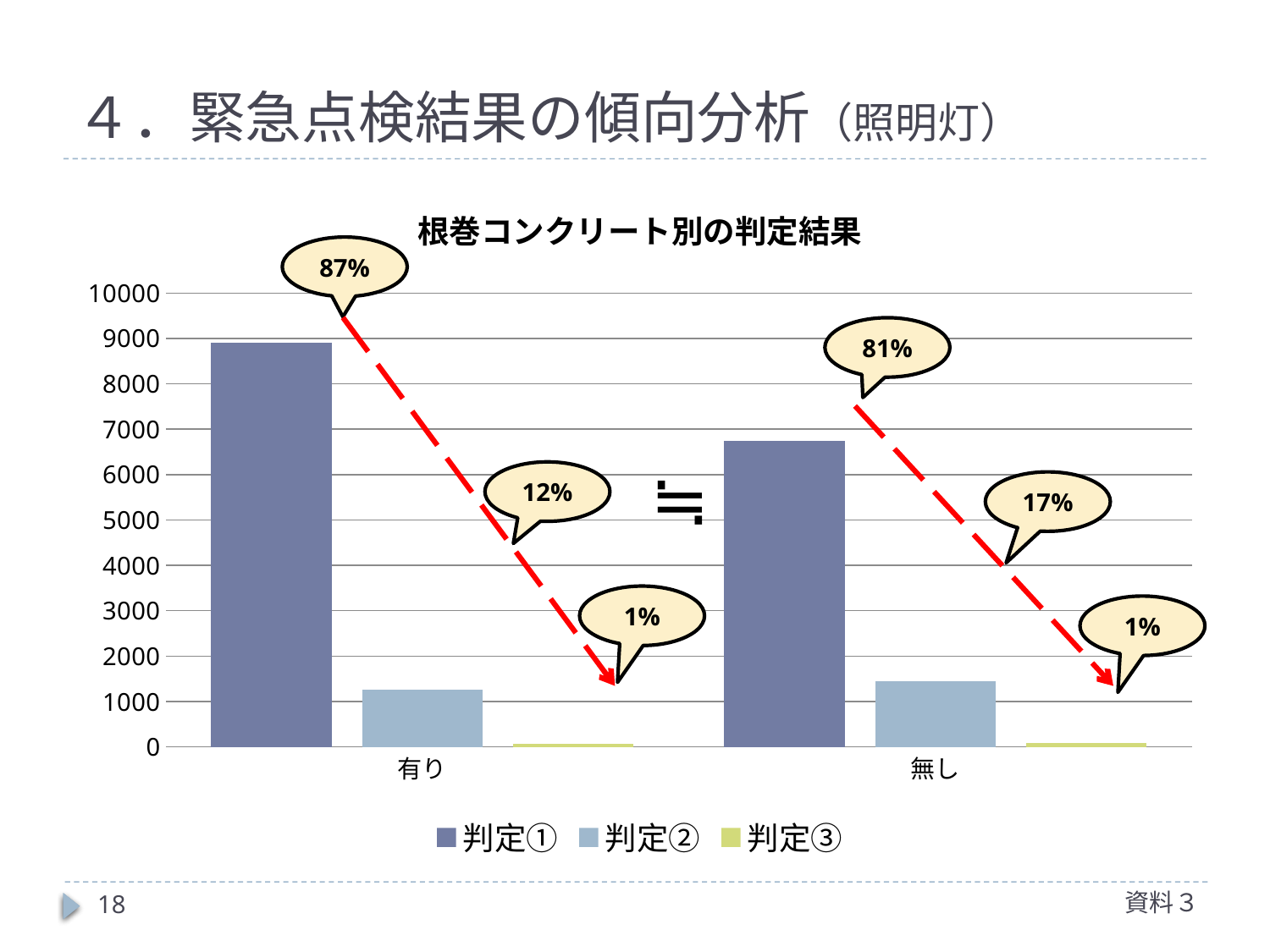
What kind of chart is shown on the slide? bar chart Which category has the highest 判定① bar? 有り What percentage is shown in the callout above the 判定① bar for 有り? 87% Is the 判定① value for 有り greater or less than 8000? greater What is the title of the chart? 根巻コンクリート別の判定結果 How many categories are shown on the x axis? 2 Which is larger, the 判定② value for 有り or for 無し? 無し Is the 判定① value for 無し greater or less than 7000? less Is the 判定② value for 無し greater or less than 1000? greater Which series has the lowest bar in the 無し category? 判定③ How many series does the legend list? 3 What percentage is shown in the callout for 判定② in the 無し category? 17%